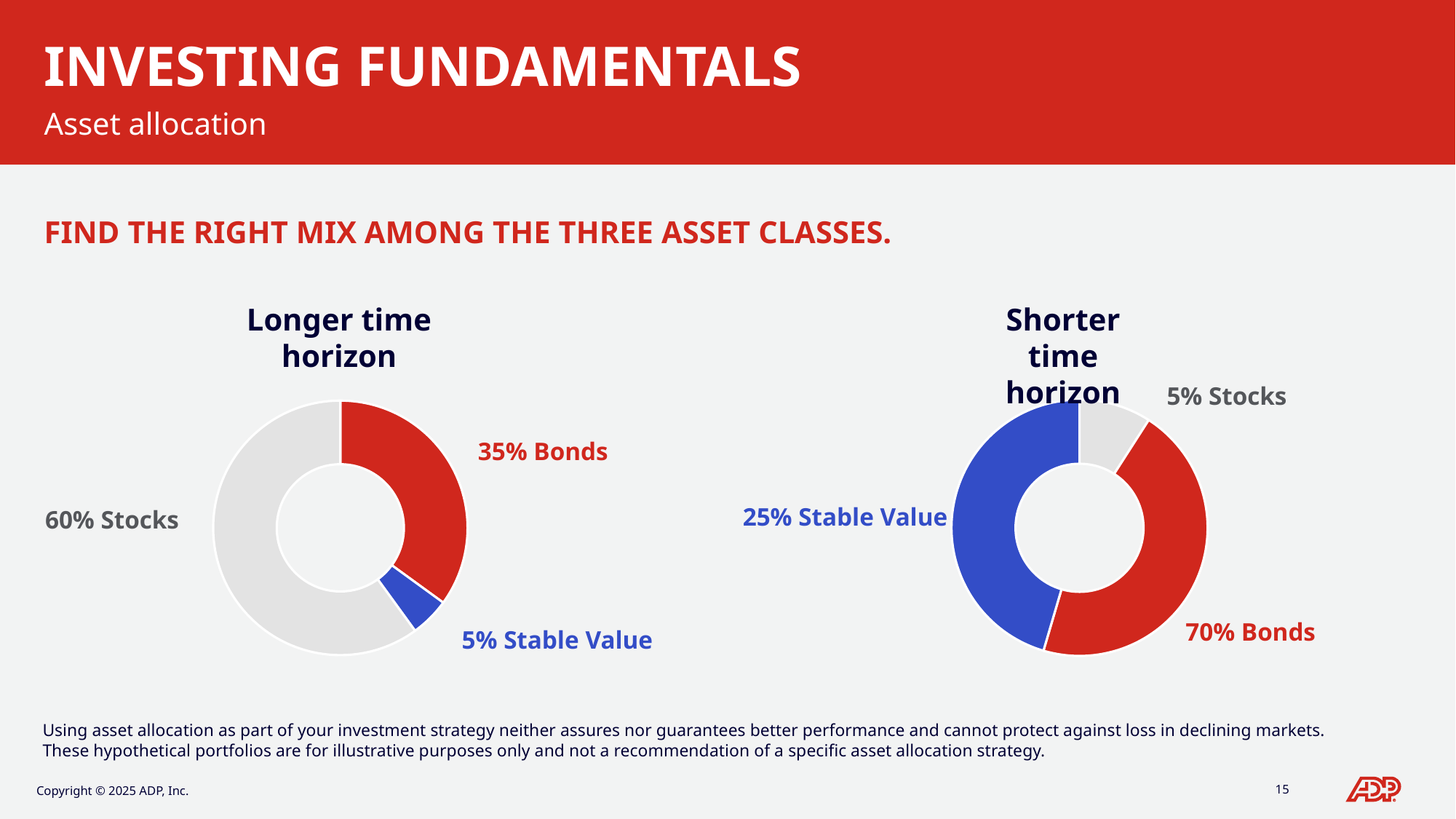
In the 'Shorter time horizon' chart, what colour is the Stable Value segment? Blue What kind of chart is the 'Shorter time horizon' chart? Doughnut chart In the 'Shorter time horizon' chart, what share is allocated to Bonds? 70% In the 'Longer time horizon' chart, what is the difference between the Stocks share and the Bonds share? 25% Which chart has the larger Bonds share, 'Longer time horizon' or 'Shorter time horizon'? Shorter time horizon In the 'Shorter time horizon' chart, what share is allocated to Stable Value? 25% In the 'Longer time horizon' chart, which asset class has the largest share? Stocks In the 'Longer time horizon' chart, what share is allocated to Stocks? 60% In the 'Shorter time horizon' chart, which asset class has the smallest share? Stocks In the 'Shorter time horizon' chart, what is the difference between the Bonds share and the Stable Value share? 45% How many asset classes are shown in the 'Longer time horizon' chart? 3 In the 'Longer time horizon' chart, what share is allocated to Bonds? 35%